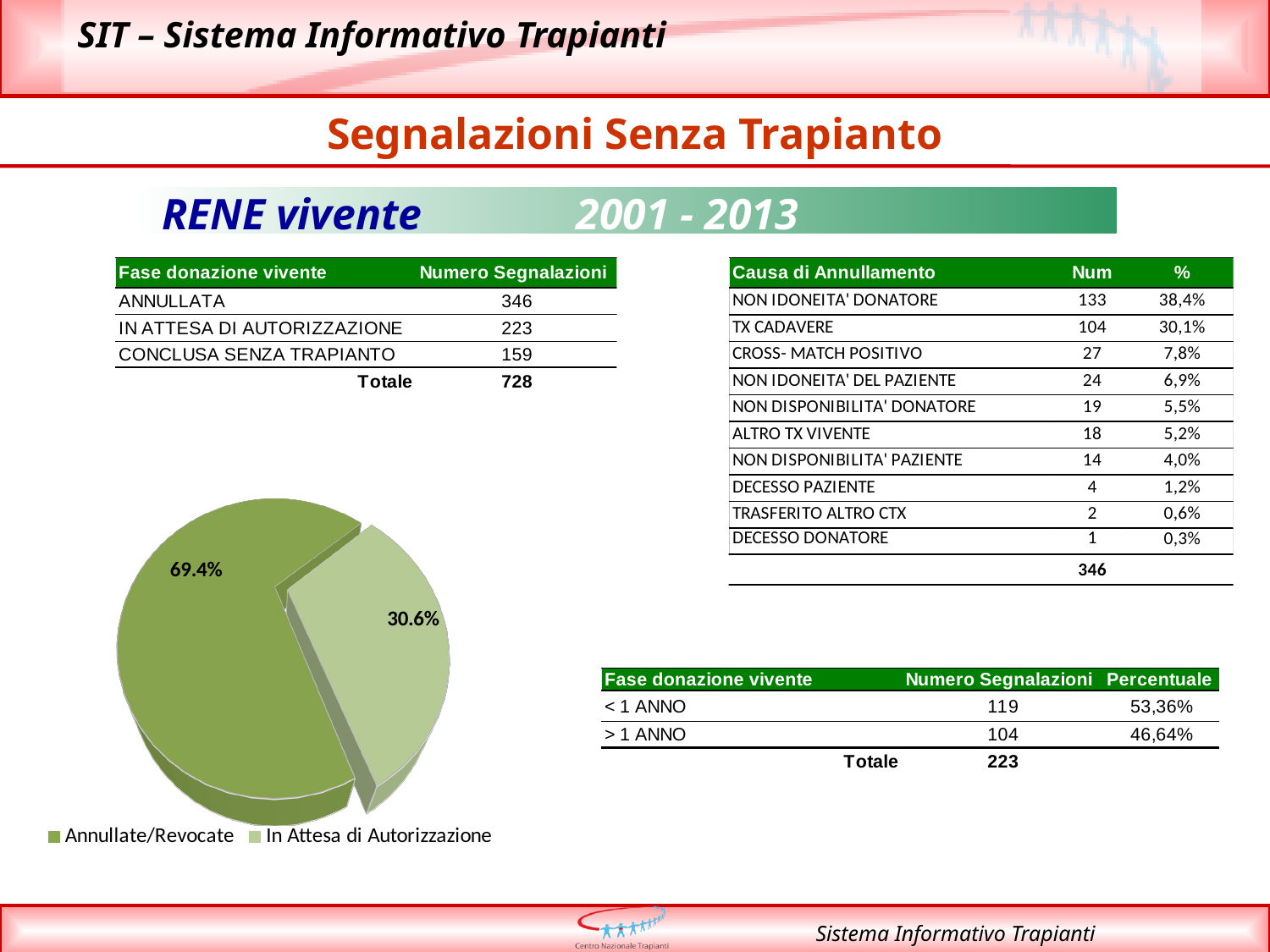
In the pie chart, which is larger: Annullate/Revocate or In Attesa di Autorizzazione? Annullate/Revocate What percentage does the pie chart show for Annullate/Revocate? 69.4% How many entries does the legend of the pie chart list? 2 Which slice of the pie chart is the smallest? In Attesa di Autorizzazione What is the difference in percentage points between the Annullate/Revocate slice and the In Attesa di Autorizzazione slice in the pie chart? 38.8% Which legend entry of the pie chart is shown in the darker green colour? Annullate/Revocate What share of the pie does the In Attesa di Autorizzazione slice represent? 30.6% Which legend entry of the pie chart is shown in the lighter green colour? In Attesa di Autorizzazione What percentage does the pie chart show for In Attesa di Autorizzazione? 30.6% What kind of chart is shown on the slide? pie chart How many slices does the pie chart have? 2 Which slice of the pie chart is the largest? Annullate/Revocate